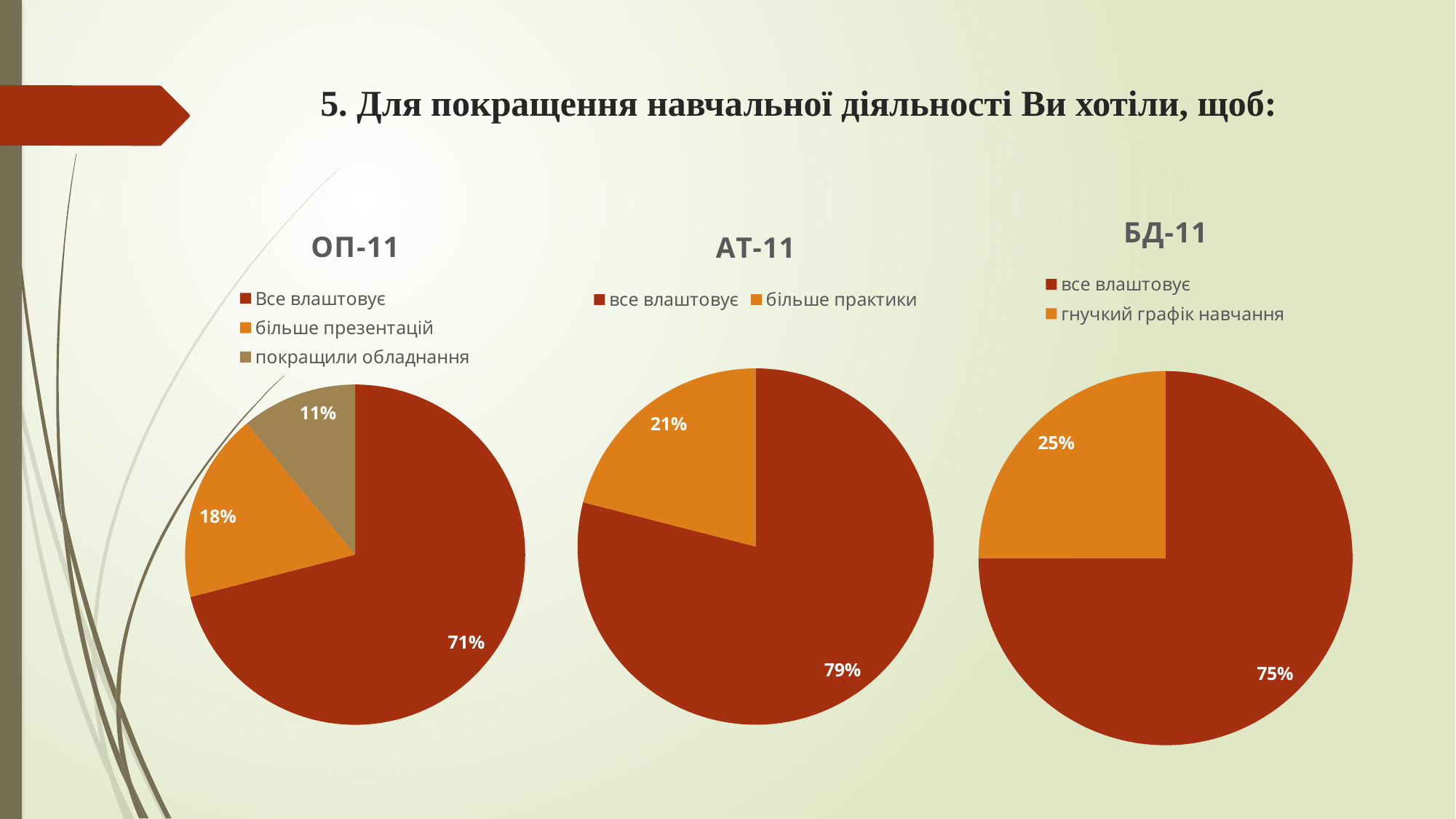
How many slices does the ОП-11 chart have? 3 How many entries does the legend of the БД-11 chart list? 2 What kind of chart is the АТ-11 chart? pie chart In the ОП-11 chart, what share is labelled for "покращили обладнання"? 11% In the ОП-11 chart, what share is labelled for "більше презентацій"? 18% In the БД-11 chart, what share is labelled for "гнучкий графік навчання"? 25% In the АТ-11 chart, what share is labelled for "більше практики"? 21% In the БД-11 chart, what share is labelled for "все влаштовує"? 75% In the ОП-11 chart, what share is labelled for "Все влаштовує"? 71% In the АТ-11 chart, which category has the largest slice? все влаштовує In the ОП-11 chart, which category has the smallest slice? покращили обладнання In the ОП-11 chart, what is the difference between the "Все влаштовує" and "більше презентацій" shares? 53%